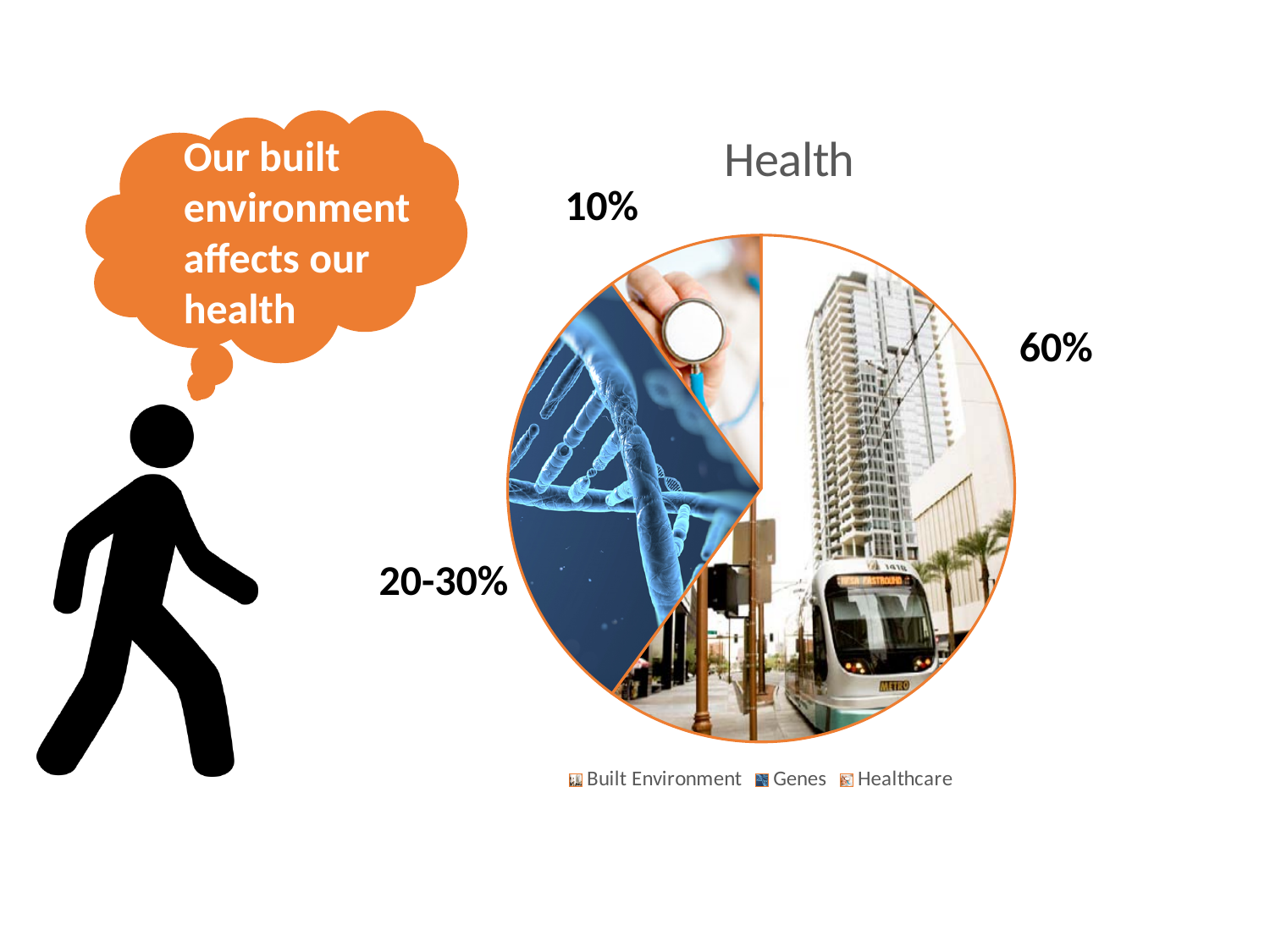
Which legend entry is listed first? Built Environment Which category has the smallest slice of the pie? Healthcare What kind of chart is shown on the slide? pie chart Which is larger, the slice for Built Environment or the slice for Genes? Built Environment What is the difference in percentage points between the Built Environment slice and the Healthcare slice? 50 How many entries does the legend list? 3 What value is shown for Genes in the pie chart? 20-30% Which category has the largest slice of the pie? Built Environment What is the title of the pie chart? Health How many categories does the pie chart have? 3 What value is shown for Healthcare in the pie chart? 10% What share of the pie does Built Environment account for? 60%